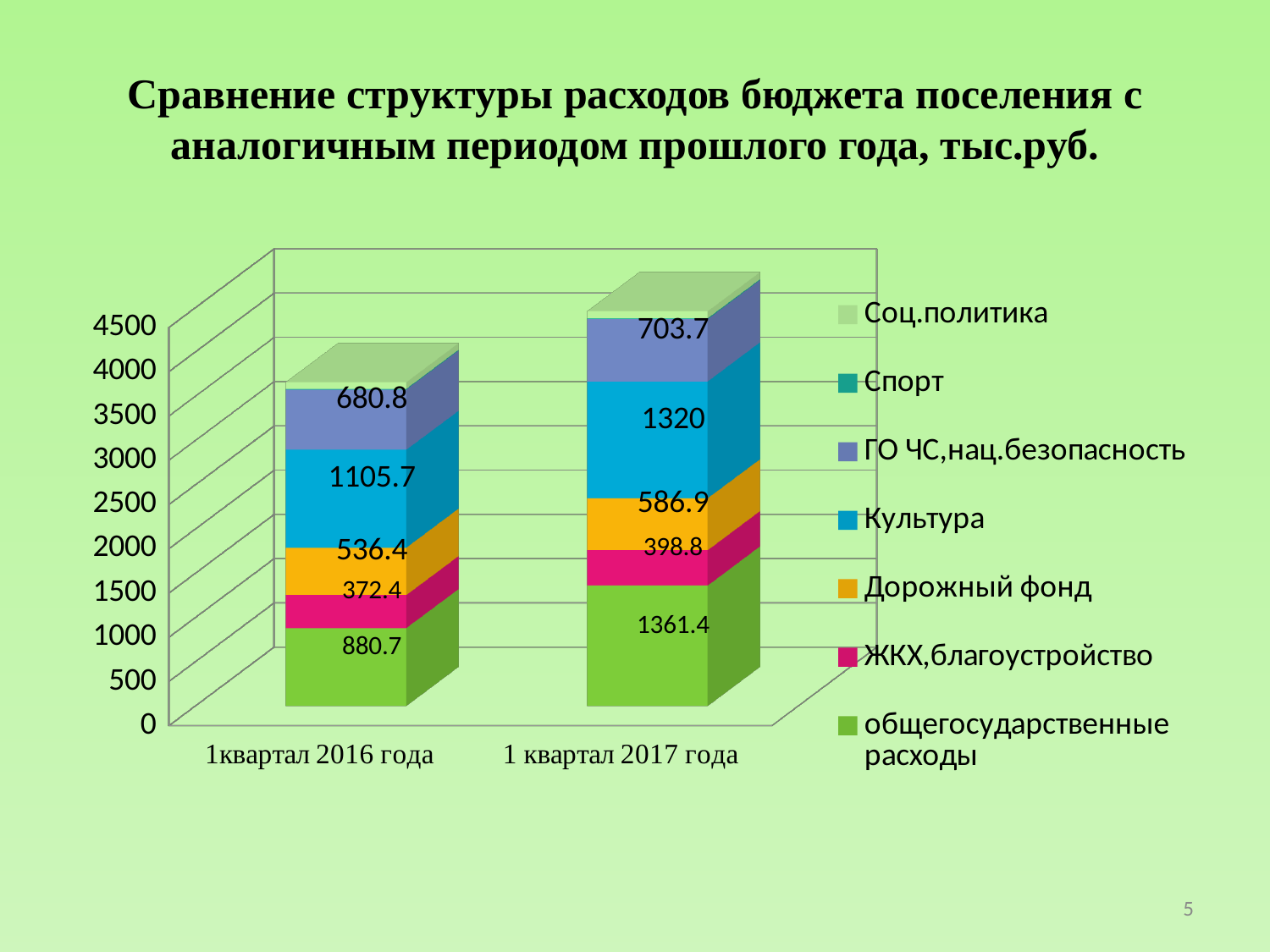
What is the difference between Дорожный фонд in 1 квартал 2017 года and in 1квартал 2016 года? 50.5 What is the value for Культура in 1 квартал 2017 года? 1320 What is the value for Дорожный фонд in 1квартал 2016 года? 536.4 What is the value for ЖКХ,благоустройство in 1 квартал 2017 года? 398.8 What is the value for общегосударственные расходы in 1квартал 2016 года? 880.7 How many series does the legend list? 7 What type of chart is shown on the slide? stacked bar chart What is the value for ГО ЧС,нац.безопасность in 1квартал 2016 года? 680.8 Which legend entry is shown in green at the bottom of the stacked bars? общегосударственные расходы How many categories are shown on the x axis? 2 Which is larger: Культура in 1квартал 2016 года or Культура in 1 квартал 2017 года? 1 квартал 2017 года What is the difference between общегосударственные расходы in 1 квартал 2017 года and in 1квартал 2016 года? 480.7